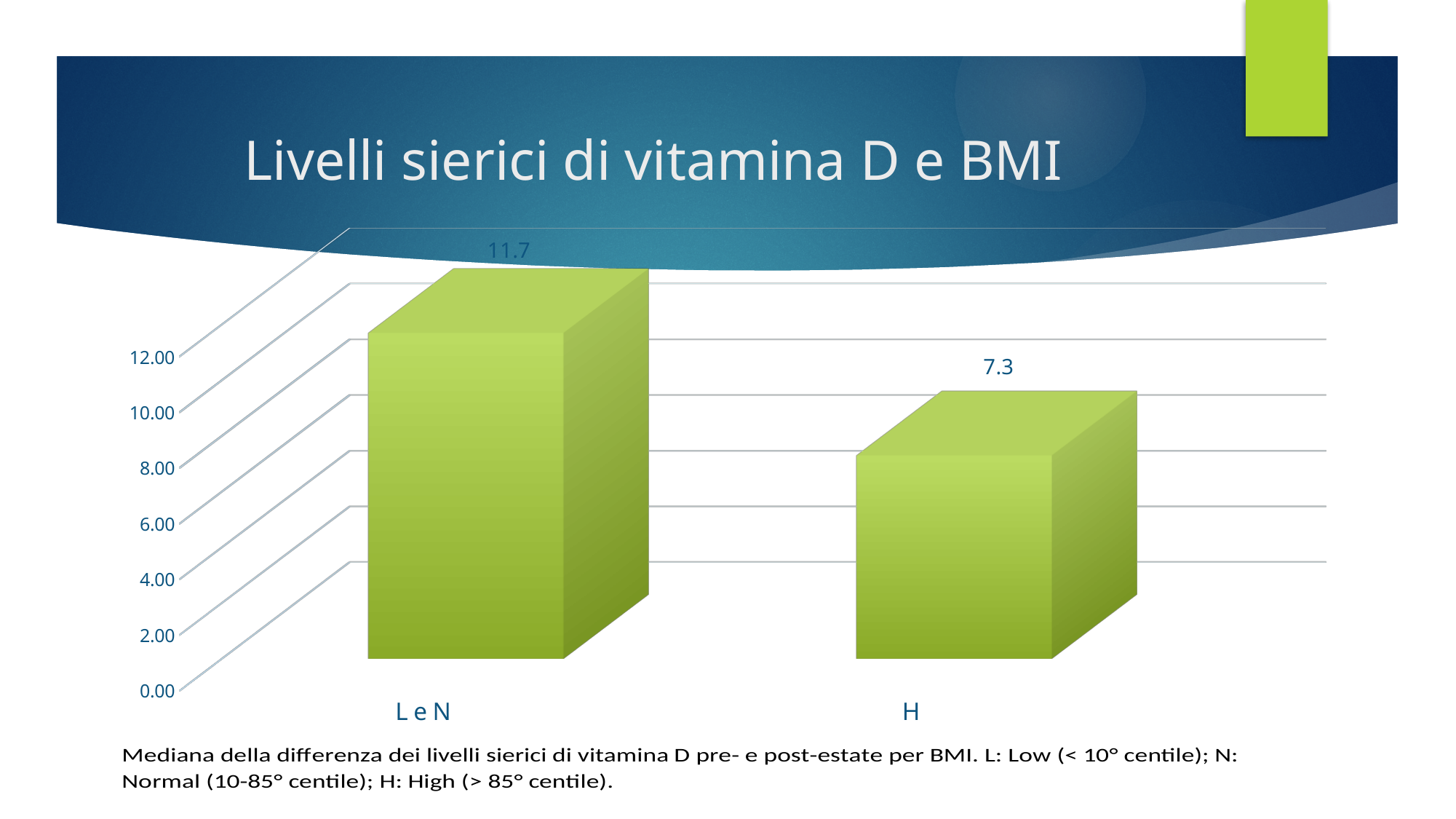
What is the value for the H category? 7.3 What kind of chart is shown on the slide? bar chart Do the values rise or fall from L e N to H? fall Which category has the highest value? L e N Which is larger, the value for L e N or the value for H? L e N What is the title of the slide containing the chart? Livelli sierici di vitamina D e BMI What is the difference between the values for L e N and H? 4.4 Is the value for L e N greater or less than 10.00? greater What is the value for the L e N category? 11.7 Is the value for H greater or less than 8.00? less Which category has the lowest value? H How many categories are shown on the x axis? 2